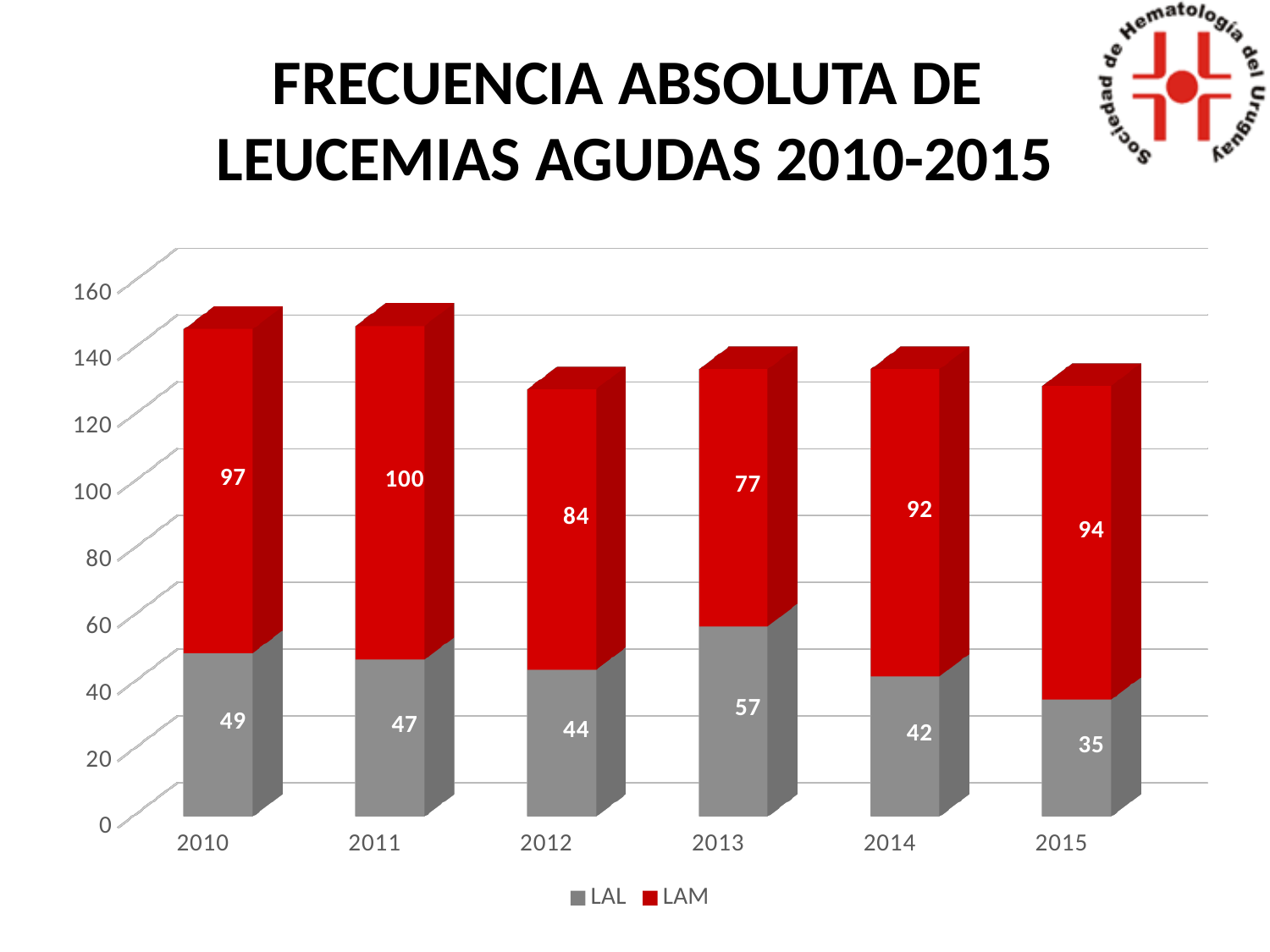
Which is larger, the LAL value for 2013 or the LAL value for 2014? LAL value for 2013 What is the total of the stacked bar for 2011? 147 What kind of chart is shown on the slide? Stacked bar chart Which year has the highest LAM value? 2011 What is the LAM value for 2011? 100 What is the LAL value for 2013? 57 Which year has the lowest LAL value? 2015 What is the total of the stacked bar for 2012? 128 How many years are shown on the x axis? 6 How many series does the legend list? 2 What is the difference between the LAM and LAL values in 2010? 48 What is the LAM value for 2015? 94